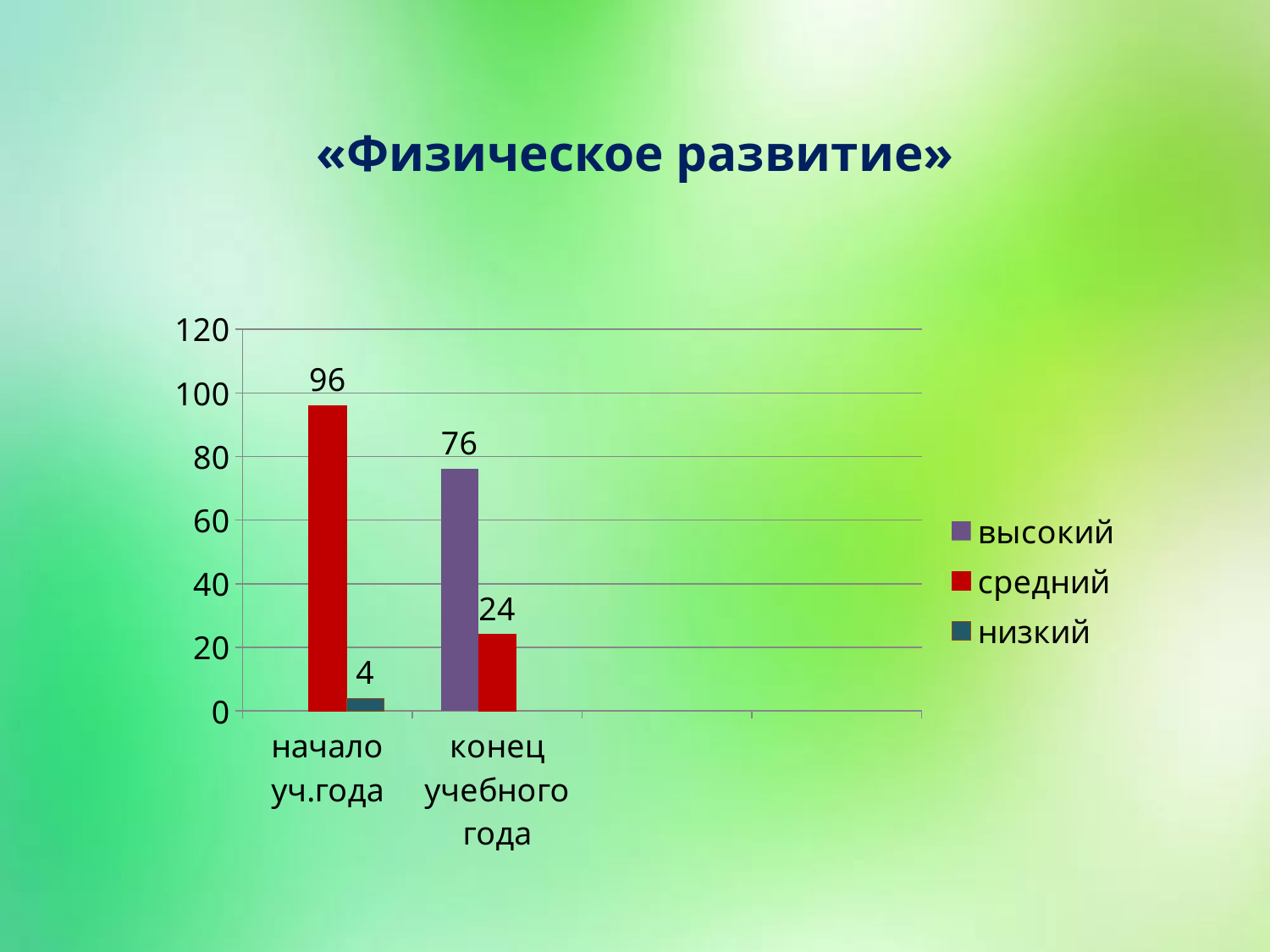
What is the title of the slide? «Физическое развитие» What is the value for низкий at начало уч.года? 4 What is the value for средний at начало уч.года? 96 Does the value for средний rise or fall from начало уч.года to конец учебного года? fall What is the value for средний at конец учебного года? 24 Which is larger: высокий at конец учебного года or средний at конец учебного года? высокий at конец учебного года Which series has the highest value at конец учебного года? высокий How many series does the legend list? 3 What is the value for высокий at конец учебного года? 76 What is the difference between the средний values at начало уч.года and конец учебного года? 72 Which series has the lowest value at начало уч.года among the bars shown? низкий What kind of chart is shown on the slide? bar chart